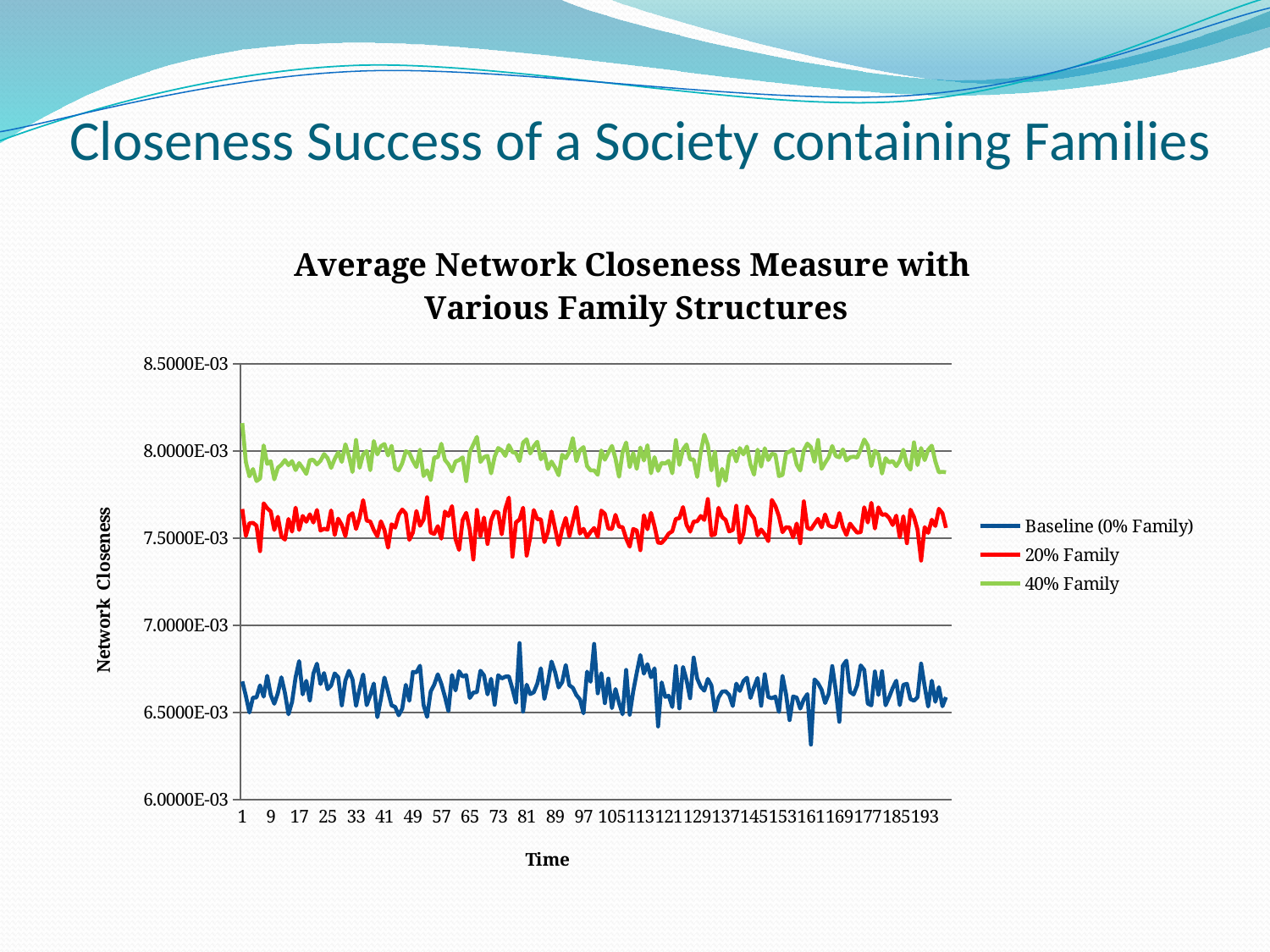
Are the values for 20% Family greater or less than 7.0000E-03 throughout the time axis? greater What is the title of the chart? Average Network Closeness Measure with Various Family Structures Which series is plotted with the green line? 40% Family Which series has larger values, 20% Family or Baseline (0% Family)? 20% Family Which series has the highest network closeness values across the time axis? 40% Family Which series has the lowest network closeness values across the time axis? Baseline (0% Family) What kind of chart is shown on the slide? Line chart Are the values for Baseline (0% Family) greater or less than 7.0000E-03 throughout the time axis? less Is the value for 40% Family at time 1 greater or less than 8.0000E-03? greater Does the 20% Family series show a clear rising or falling trend along the time axis, or does it stay roughly flat? Roughly flat What is the highest value shown on the y axis? 8.5000E-03 How many series does the legend list? 3